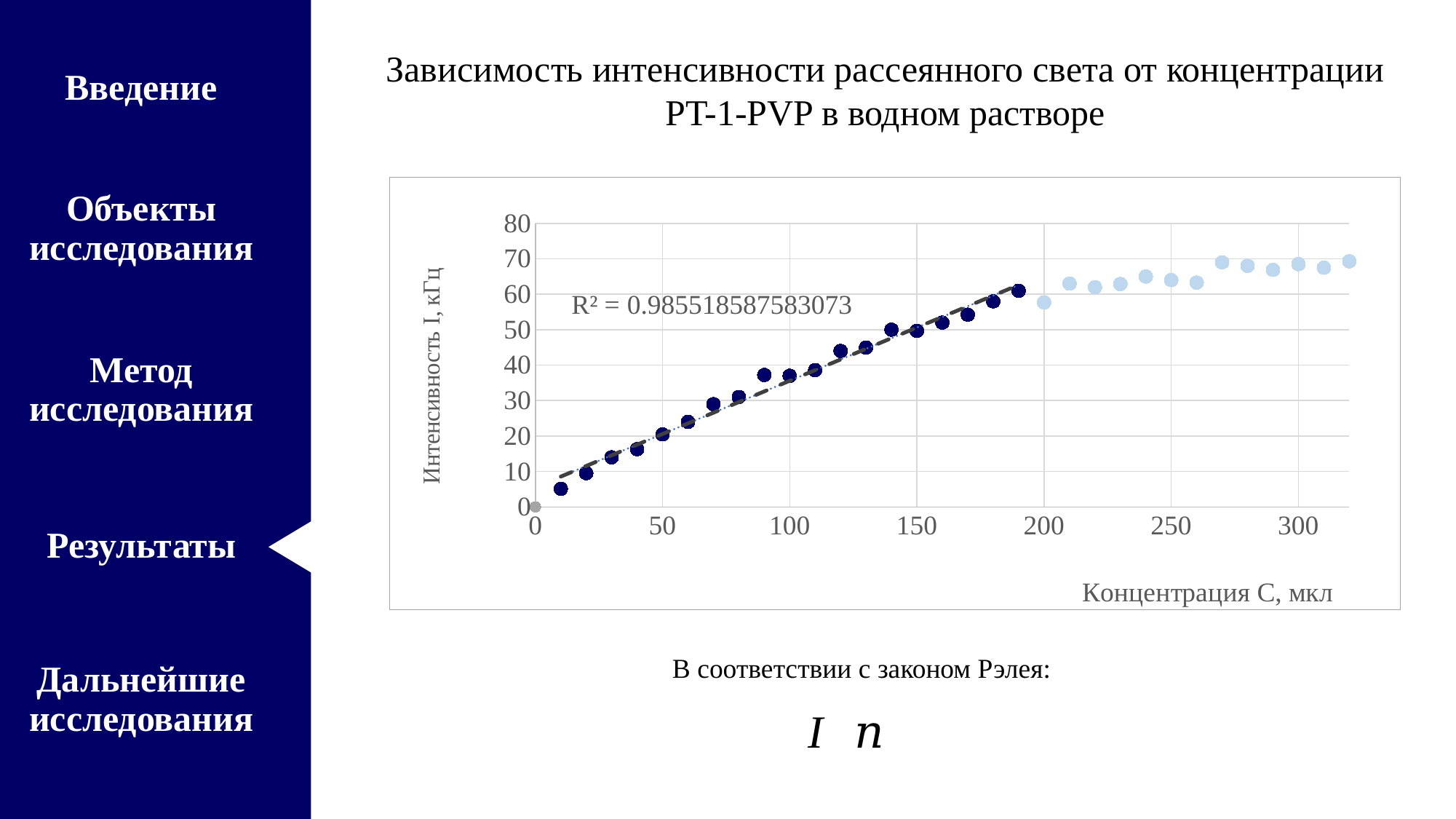
What kind of chart is shown on the slide? scatter chart What is the label of the vertical axis of the chart? Интенсивность I, кГц Do the plotted intensity values rise or fall as concentration increases along the x axis? rise What R² value is printed on the chart? R² = 0.985518587583073 Is the intensity value at a concentration of 100 greater or less than 40? less Which has the larger intensity value: the point at concentration 50 or the point at concentration 150? 150 Is the intensity value at a concentration of 250 greater or less than 60? greater Is the intensity value at a concentration of 100 greater or less than 30? greater Which has the larger intensity value: the point at concentration 300 or the point at concentration 100? 300